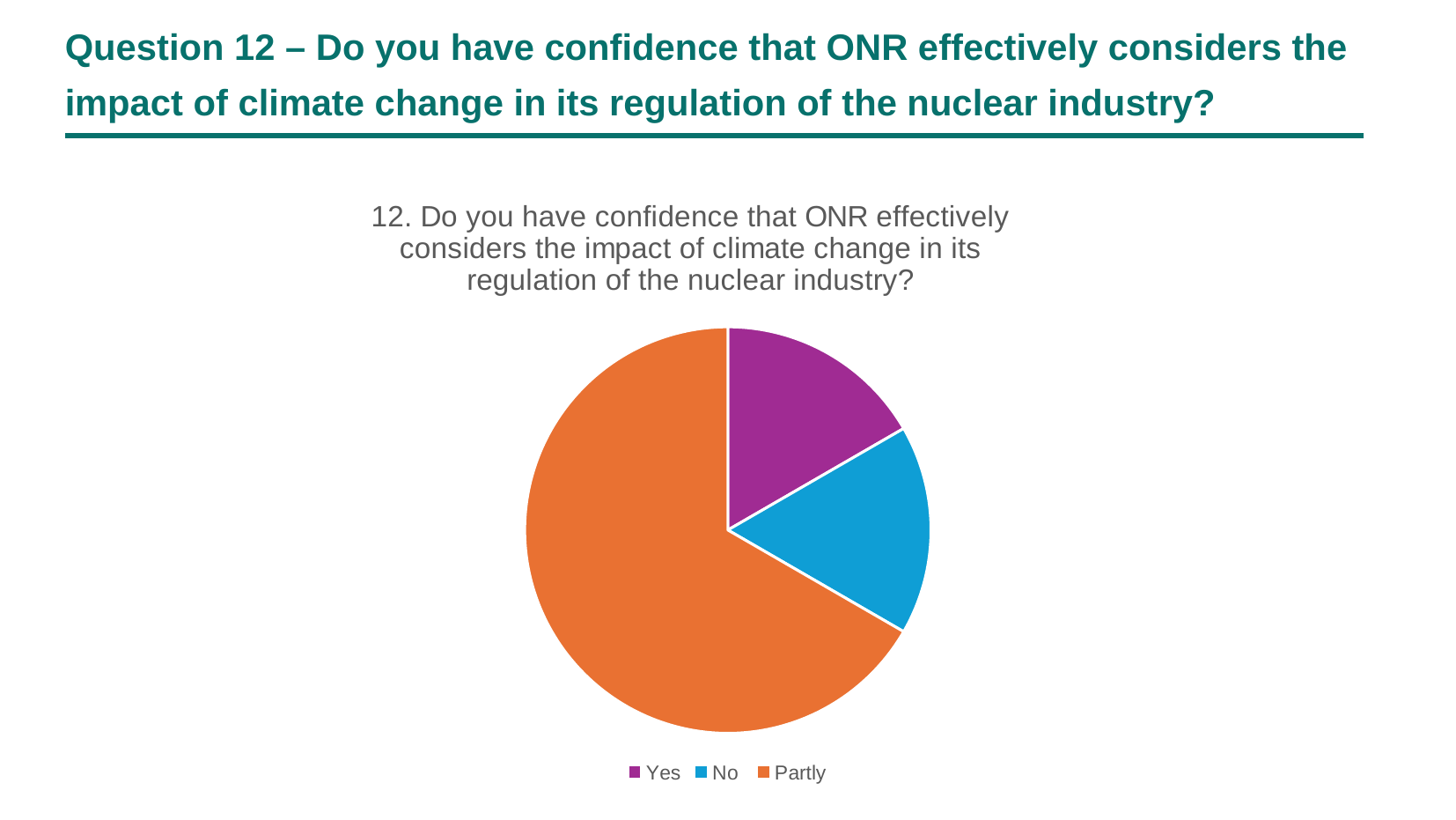
Which slice is larger, Partly or Yes? Partly How many entries does the legend of the pie chart list? 3 Which response category is shown in purple in the pie chart? Yes What colour is the Partly slice in the pie chart? Orange Which response category has the largest slice of the pie chart? Partly Which slice is larger, Partly or No? Partly How many slices does the pie chart have? 3 What kind of chart is shown on the slide? Pie chart